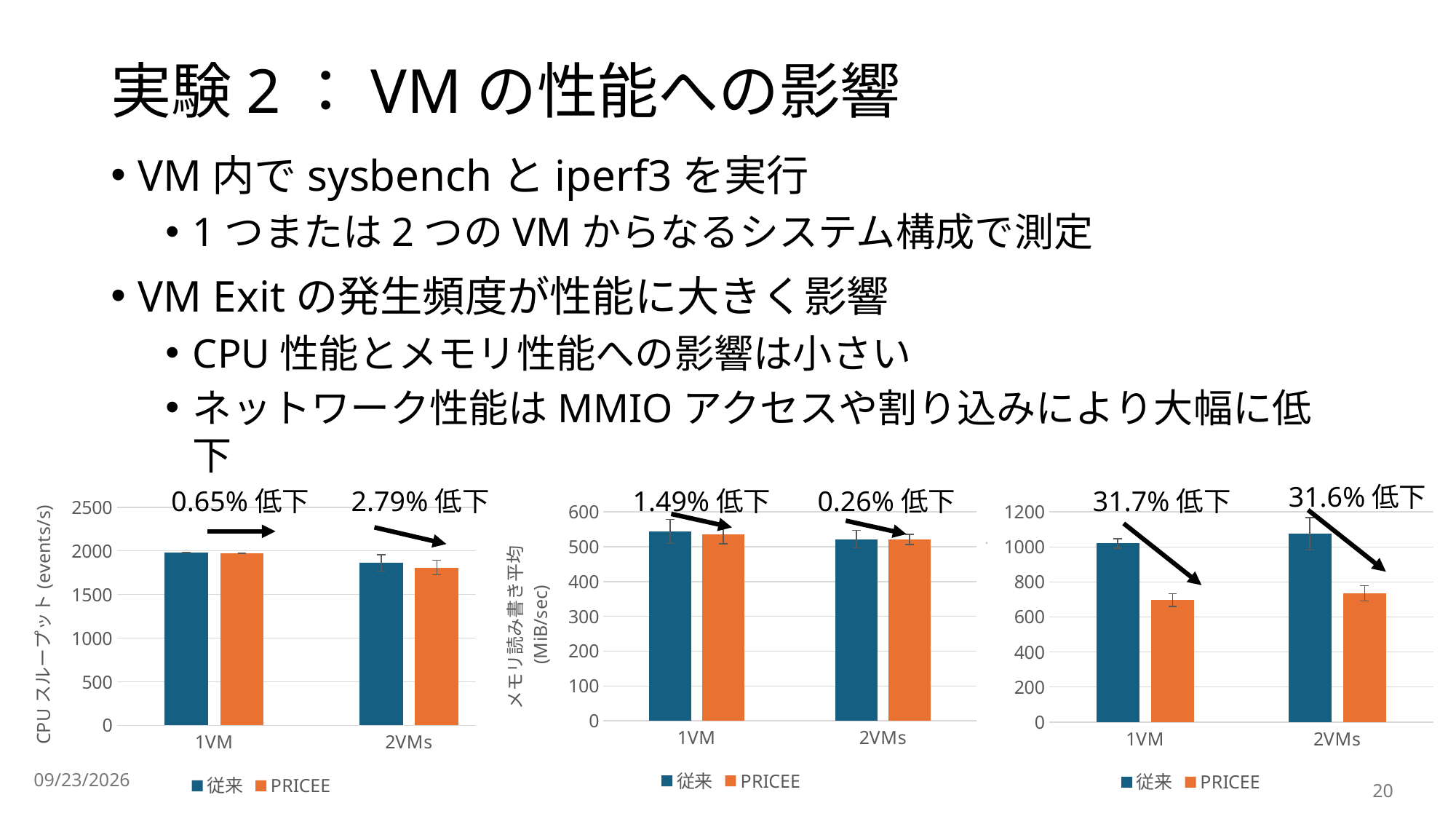
How many categories are shown on the x axis of the right chart? 2 What percentage decrease is annotated above the 1VM bars in the right chart? 31.7% 低下 In the middle chart (メモリ読み書き平均), is the value for PRICEE at 2VMs greater or less than 600? less What kind of chart is the left chart (CPU スループット)? bar chart In the left chart (CPU スループット), is the value for 従来 at 1VM greater or less than 1500? greater How many series does the legend of the middle chart (メモリ読み書き平均) list? 2 In the right chart, which bar is the highest? 従来 at 2VMs In the left chart (CPU スループット), which is larger for 従来: 1VM or 2VMs? 1VM In the right chart, which is larger at 1VM: 従来 or PRICEE? 従来 In the right chart, is the value for PRICEE at 1VM greater or less than 800? less